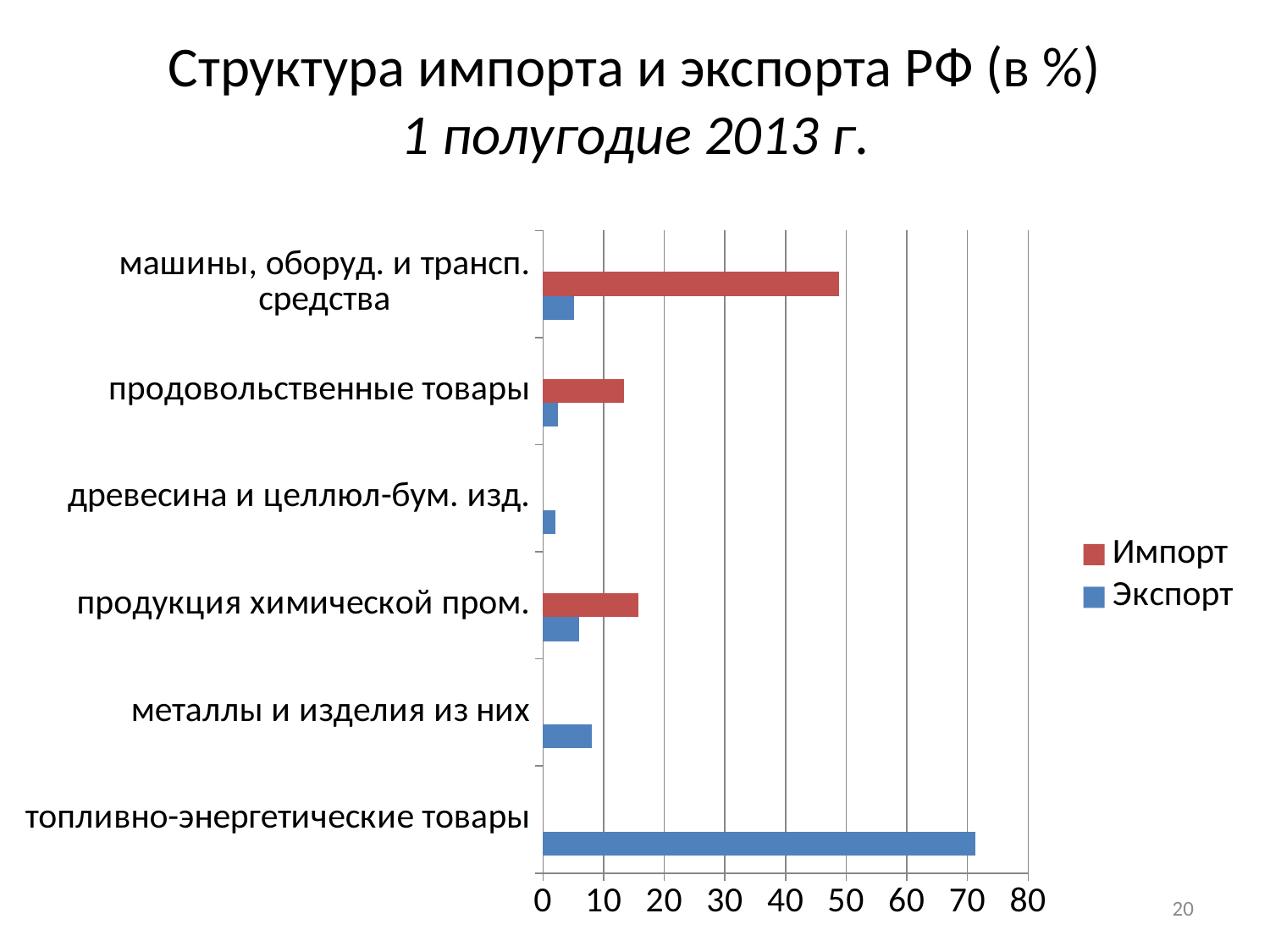
For машины, оборуд. и трансп. средства, which is larger: Импорт or Экспорт? Импорт How many series does the legend list? 2 Which is larger: the Импорт value for продукция химической пром. or the Импорт value for продовольственные товары? продукция химической пром. Which category has the highest Импорт value? машины, оборуд. и трансп. средства Is the Импорт value for продукция химической пром. greater or less than 10? greater Which colour represents the Экспорт series in the legend? blue Is the Импорт value for машины, оборуд. и трансп. средства greater or less than 50? less Which category has the highest Экспорт value? топливно-энергетические товары Is the Экспорт value for топливно-энергетические товары greater or less than 70? greater How many categories are shown on the chart? 6 What kind of chart is shown on the slide? bar chart